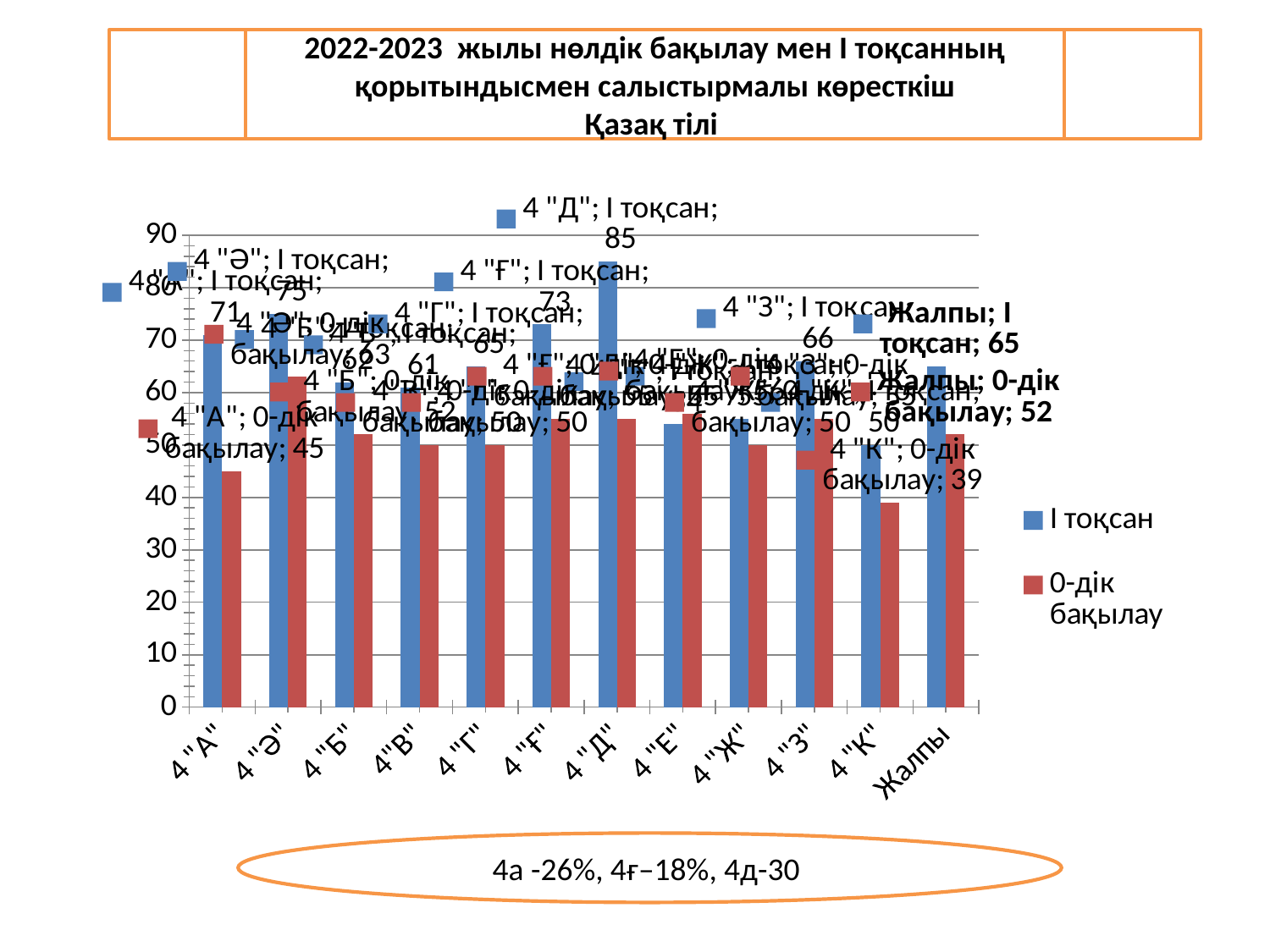
How many categories are shown on the x axis? 12 Which category has the lowest 0-дік бақылау value? 4 "К" How many series does the legend list? 2 Is the І тоқсан value for 4 "Е" greater or less than 60? less Which category has the highest І тоқсан value? 4 "Д" What is the І тоқсан value for 4 "Д"? 85 What is the difference between the І тоқсан and 0-дік бақылау values for 4 "А"? 26 Which has the larger І тоқсан value, 4 "Д" or 4 "А"? 4 "Д" What kind of chart is shown on the slide? bar chart What is the 0-дік бақылау value for 4 "А"? 45 What is the 0-дік бақылау value for 4 "К"? 39 What is the І тоқсан value for Жалпы? 65